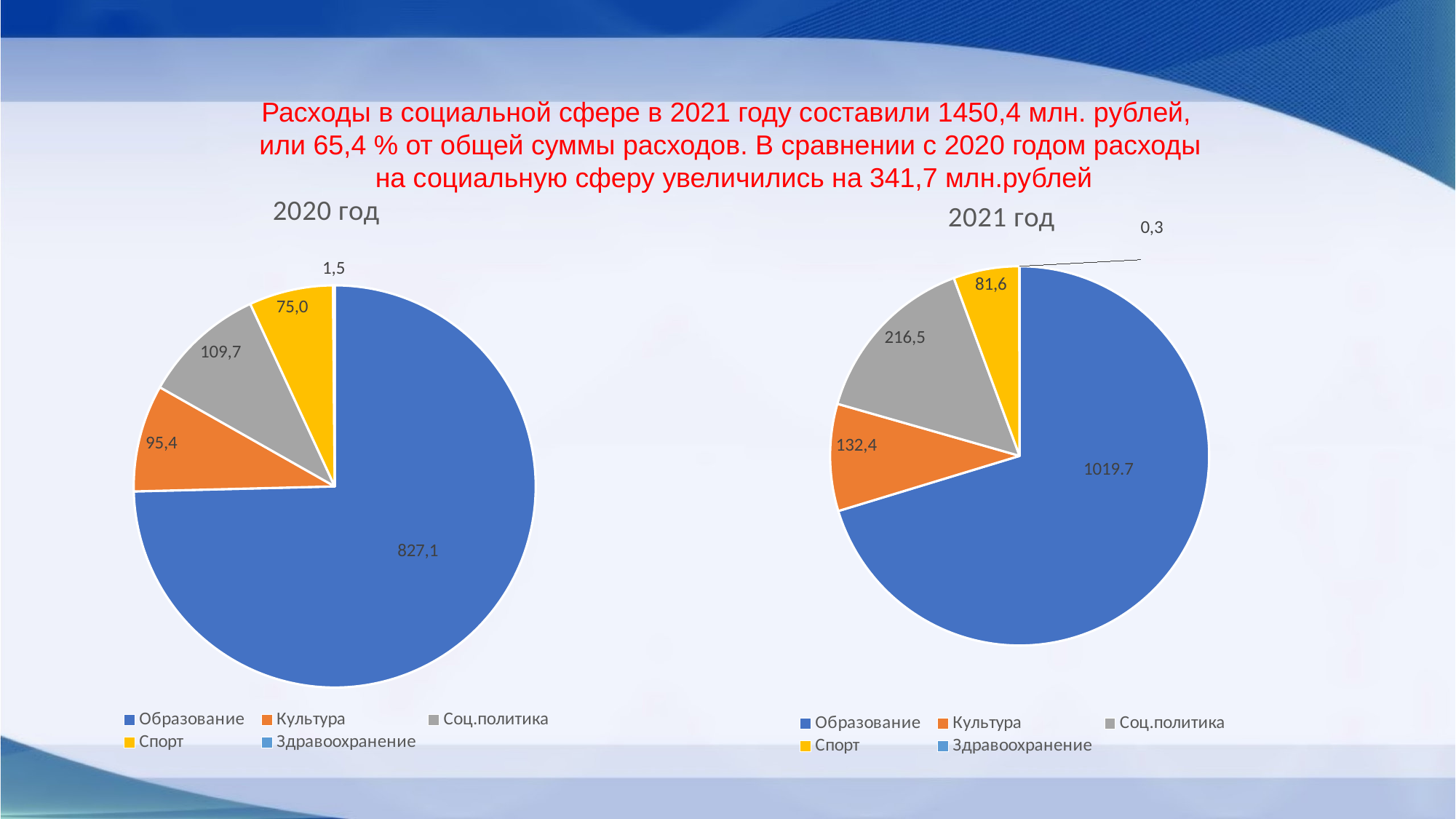
In the "2020 год" chart, which category has the smallest slice? Здравоохранение In the "2020 год" chart, what is the value for Образование? 827,1 In the "2021 год" chart, which category has the largest slice? Образование In the "2021 год" chart, what is the value for Здравоохранение? 0,3 How many entries does the legend of the "2021 год" chart list? 5 What type of chart is the "2021 год" chart? Pie chart In the "2020 год" chart, which is larger: Соц.политика or Культура? Соц.политика In the "2020 год" chart, what is the value for Спорт? 75,0 In the "2020 год" chart, which colour represents Культура? Orange How many slices does the "2020 год" pie chart have? 5 In the "2021 год" chart, what is the difference between the values for Соц.политика and Культура? 84,1 In the "2021 год" chart, what is the value for Соц.политика? 216,5